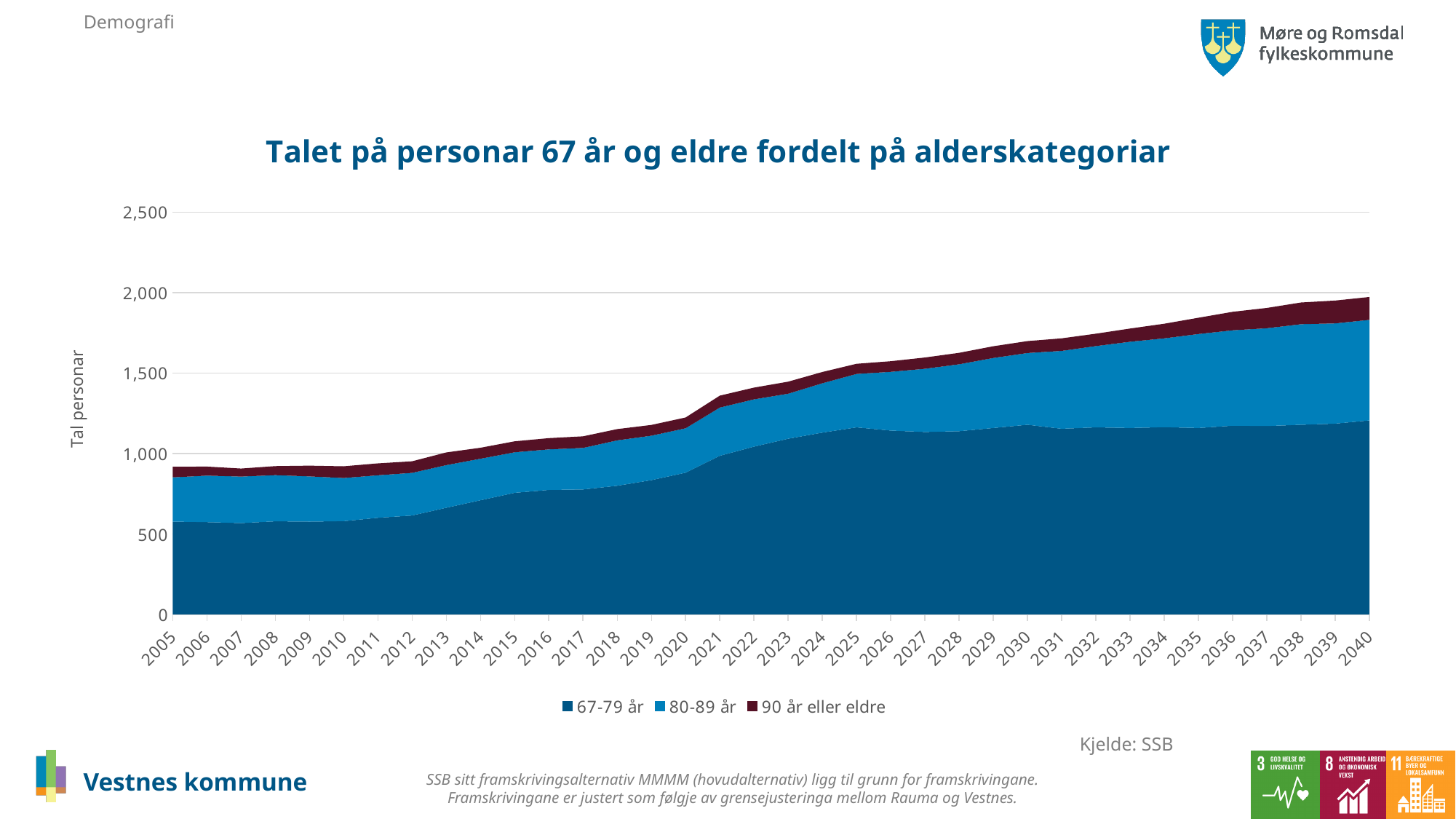
Which age category has the smallest number of persons in 2040? 90 år eller eldre Does the total number of persons 67 years and older rise or fall from 2005 to 2040? Rise Is the total number of persons 67 years and older in 2040 greater or less than 1,500? greater Which age category has the largest number of persons in 2040? 67-79 år Is the value for the 67-79 år series in 2040 greater or less than 1,000? greater Is the total number of persons 67 years and older in 2030 greater or less than 1,500? greater How many series does the legend list? 3 What is the title of the chart? Talet på personar 67 år og eldre fordelt på alderskategoriar What kind of chart is shown on the slide? Stacked area chart How many years are shown along the x axis? 36